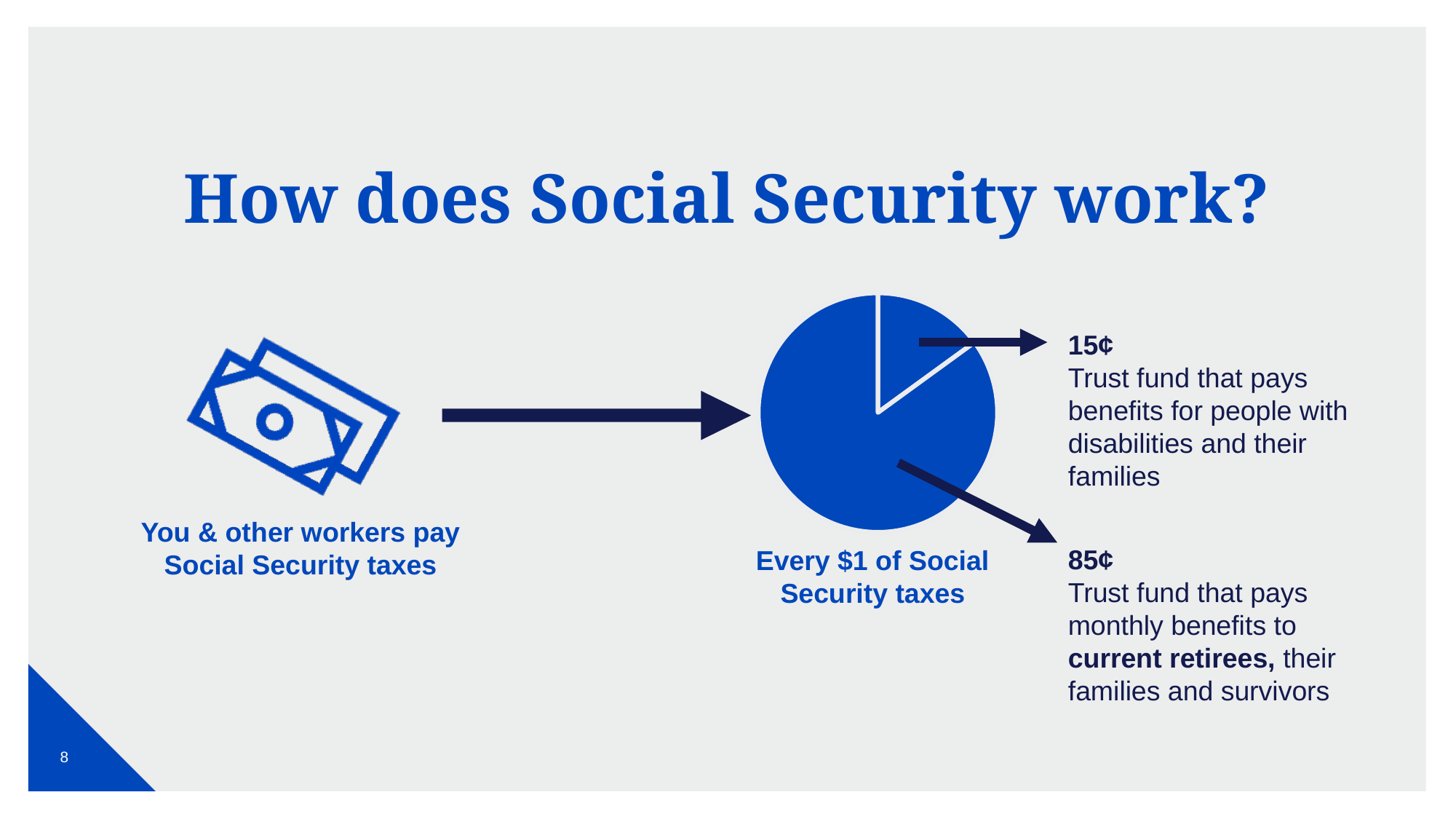
How much of every $1 of Social Security taxes goes to the trust fund that pays benefits for people with disabilities and their families? 15¢ How much of every $1 of Social Security taxes goes to the trust fund that pays monthly benefits to current retirees, their families and survivors? 85¢ Which slice of the pie chart is the largest? 85¢ (trust fund for current retirees, their families and survivors) What is the difference between the amount going to the retirees trust fund and the amount going to the disability trust fund? 70¢ What do the two slices of the pie chart add up to? $1 What share of the pie does the disability trust fund slice represent? 15% What kind of chart is shown on the slide? pie chart Which receives more of each Social Security tax dollar: the disability trust fund or the retirees trust fund? the retirees trust fund What is the title of the slide? How does Social Security work? What is the label beneath the pie chart? Every $1 of Social Security taxes Which slice of the pie chart is the smallest? 15¢ (trust fund for people with disabilities and their families) How many slices does the pie chart have? 2